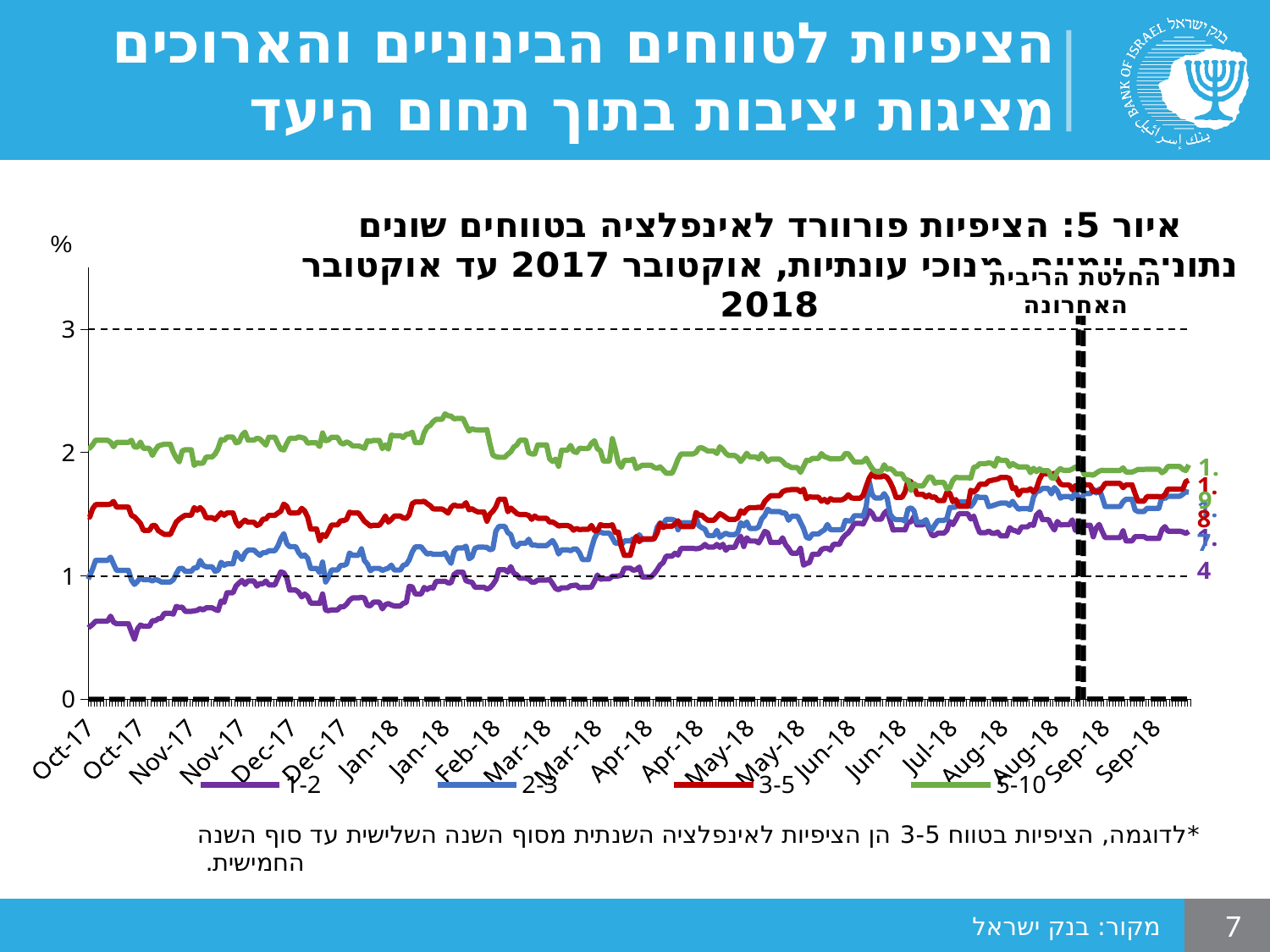
What unit is shown on the y axis? % Is the value of the 2-3 series at Sep-18 greater or less than 1? greater Is the value of the 3-5 series at Oct-17 greater or less than 1? greater Is the value of the 1-2 series at Oct-17 greater or less than 1? less At Oct-17, which series has the larger value, 3-5 or 2-3? 3-5 Does the 1-2 series generally rise or fall from Oct-17 to Sep-18? rise How many series does the legend list? 4 Which series has the lowest values at the start of the period (Oct-17)? 1-2 What colour is the line for the 5-10 series? green Which series has the highest values throughout the period shown? 5-10 What kind of chart is shown on the slide? line chart